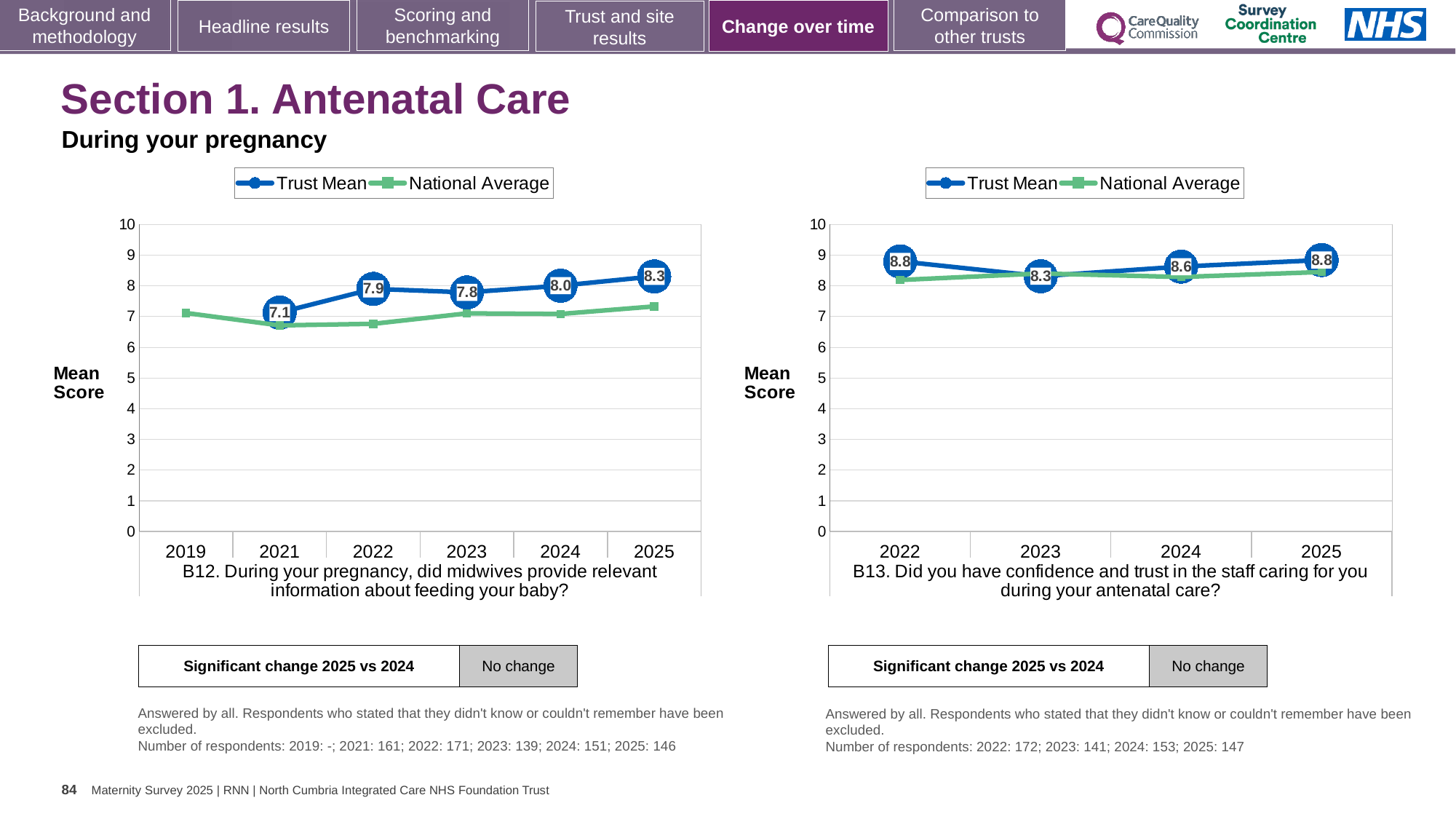
In the B12 chart (left), is the National Average for 2021 greater or less than 7? less How many years are shown on the x axis of the B13 chart (right)? 4 What type of chart is the B12 chart (left)? Line chart In the B12 chart (left), which year has the lowest Trust Mean? 2021 In the B12 chart (left), which year has the highest Trust Mean? 2025 In the B12 chart (left), what is the difference between the Trust Mean in 2025 and in 2021? 1.2 In the B13 chart (right), what is the Trust Mean for 2023? 8.3 In the B12 chart (left), what is the Trust Mean for 2021? 7.1 In the B12 chart (left), is the Trust Mean higher in 2022 or in 2023? 2022 In the B12 chart (left), what is the Trust Mean for 2025? 8.3 In the B13 chart (right), which year has the lowest Trust Mean? 2023 In the B13 chart (right), what is the difference between the Trust Mean in 2022 and in 2023? 0.5